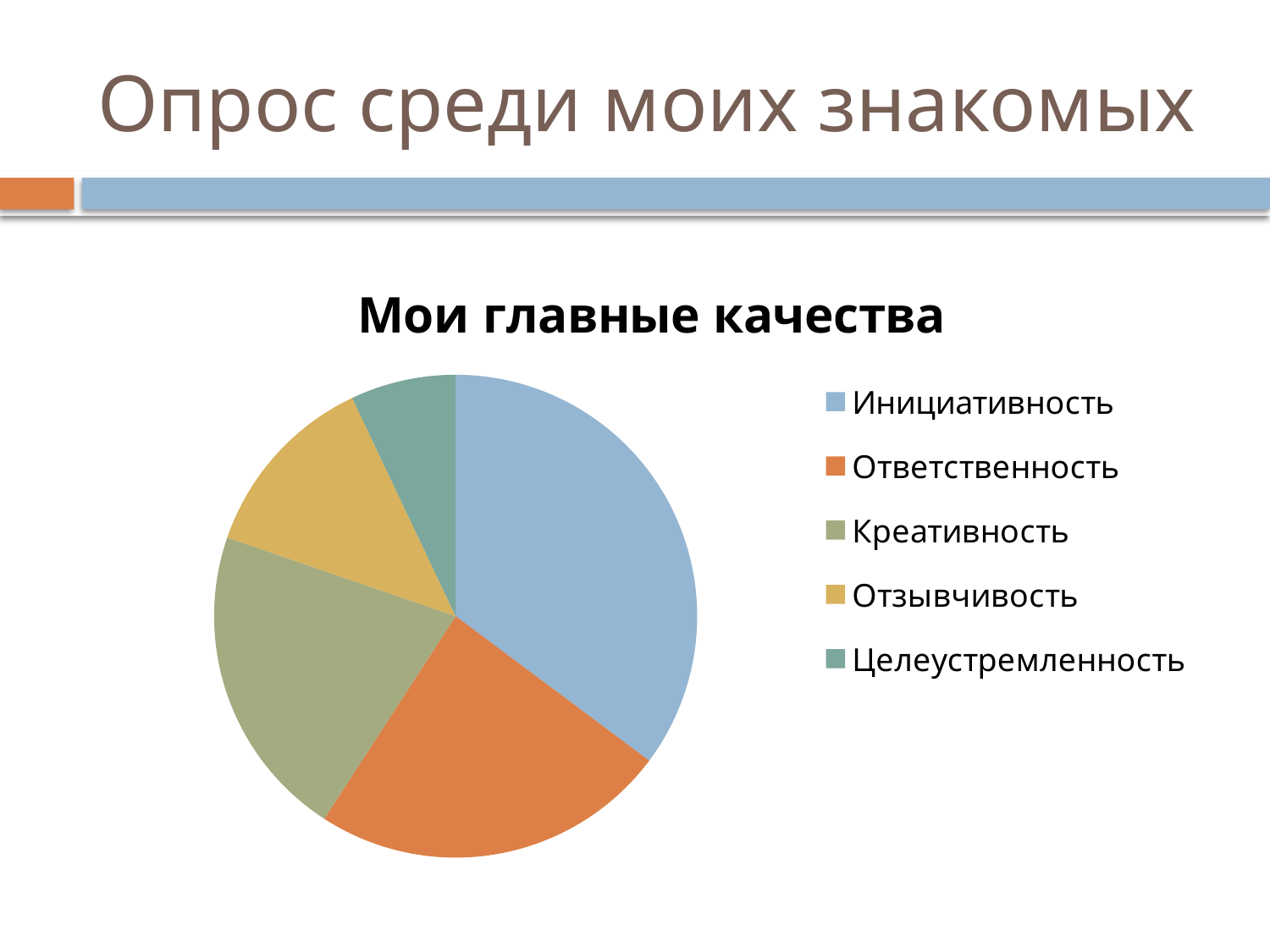
What colour is the slice for Ответственность? Orange Which slice is larger, Креативность or Целеустремленность? Креативность What kind of chart is shown on the slide? Pie chart Which slice is larger, Отзывчивость or Целеустремленность? Отзывчивость Which quality has the largest slice of the pie? Инициативность How many slices does the pie chart have? 5 Which slice is larger, Инициативность or Ответственность? Инициативность Which quality has the smallest slice of the pie? Целеустремленность What is the title of the chart? Мои главные качества How many entries does the legend list? 5